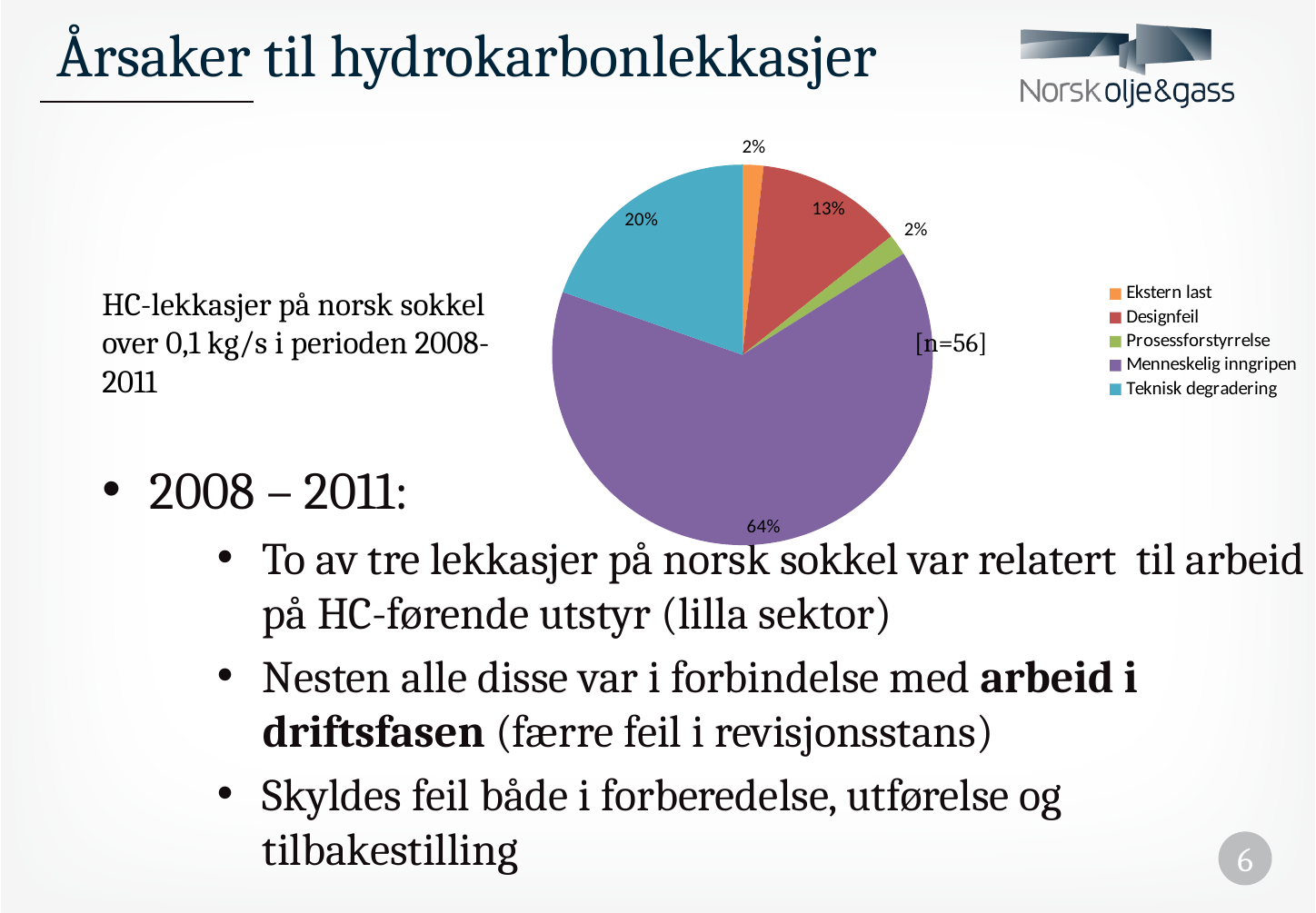
What is the difference in percentage points between Menneskelig inngripen and Teknisk degradering? 44 percentage points Which category has the largest slice of the pie? Menneskelig inngripen What share of the pie does Menneskelig inngripen account for? 64% What sample size is noted next to the pie chart? [n=56] What kind of chart is shown on the slide? pie chart Which is larger, the slice for Designfeil or the slice for Teknisk degradering? Teknisk degradering What share of the pie does Designfeil account for? 13% What share of the pie does Prosessforstyrrelse account for? 2% How many categories does the legend list? 5 Which colour represents Menneskelig inngripen in the pie chart? purple